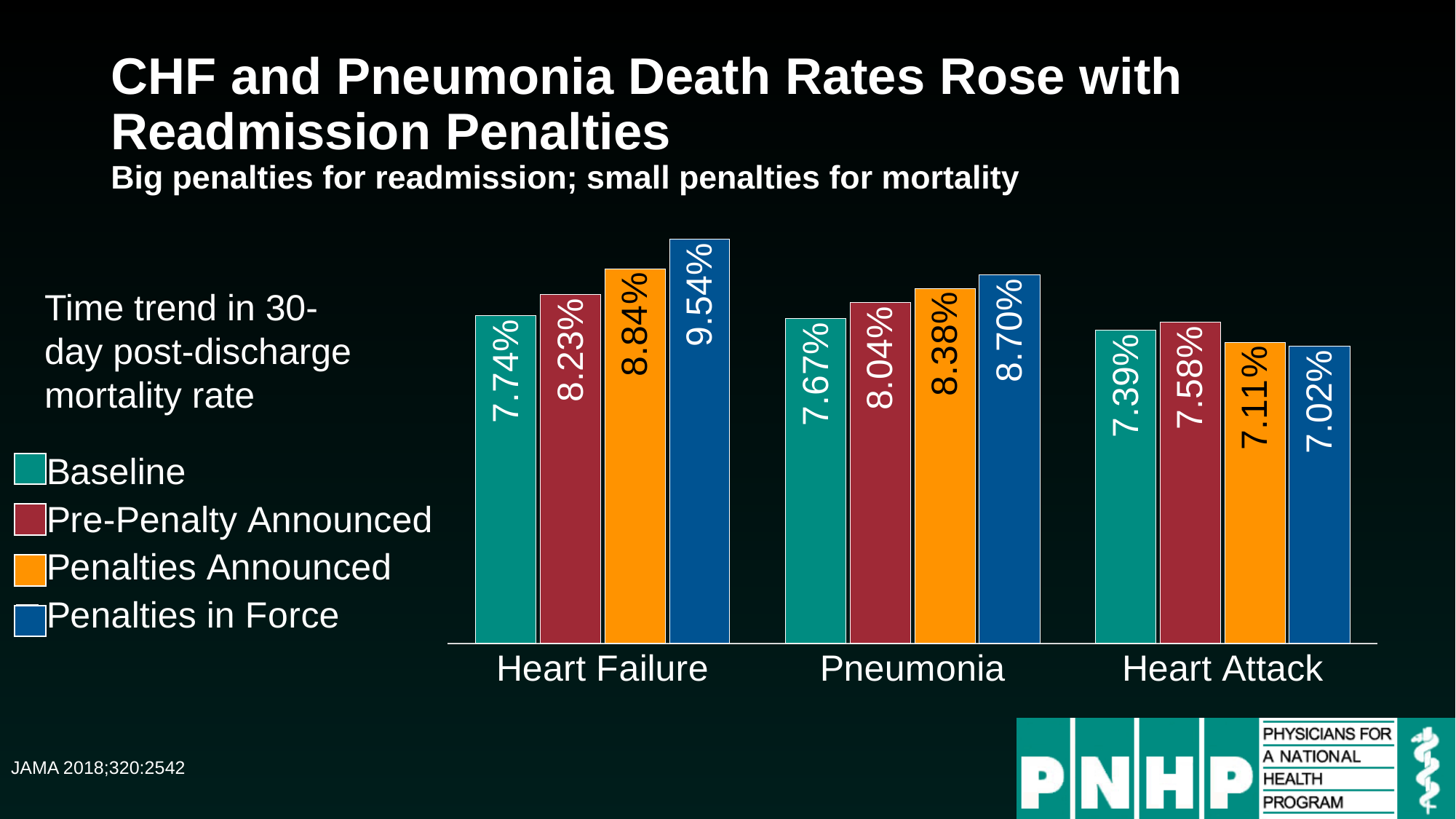
Which series has the lowest value for Heart Attack? Penalties in Force What kind of chart is shown on the slide? Bar chart How many series does the legend list? 4 Which legend entry is shown in orange? Penalties Announced What is the Penalties in Force mortality rate for Pneumonia? 8.70% What is the Penalties Announced mortality rate for Heart Attack? 7.11% Which condition has the highest Penalties in Force mortality rate? Heart Failure Do the mortality rates for Heart Attack rise or fall from Pre-Penalty Announced to Penalties in Force? Fall What is the Baseline mortality rate for Heart Failure? 7.74% Which is larger for Pneumonia: the Pre-Penalty Announced rate or the Penalties Announced rate? Penalties Announced What is the difference between the Penalties in Force and Baseline mortality rates for Heart Failure? 1.80% How many conditions are shown on the x axis? 3